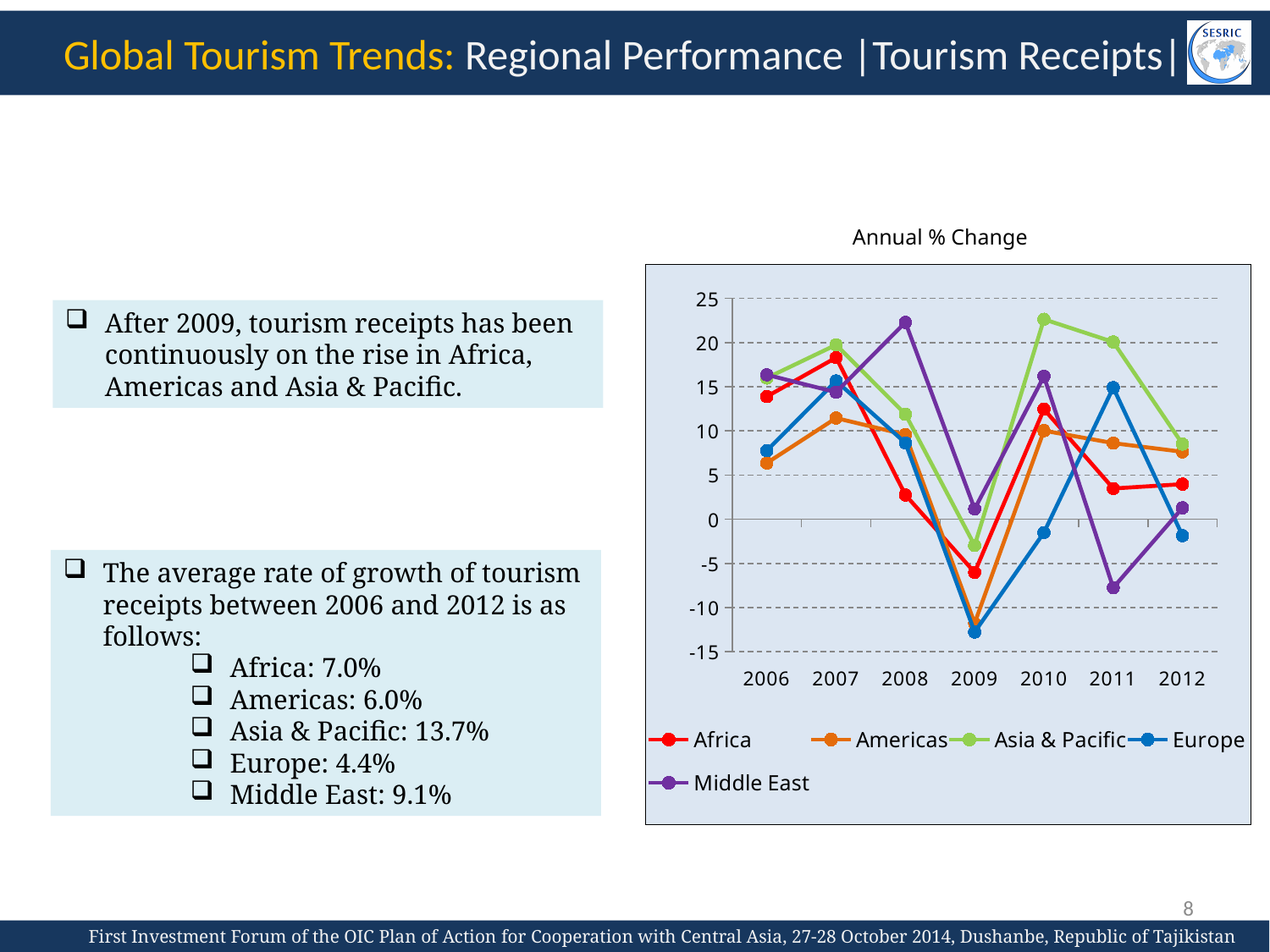
Which region has the highest value in 2010? Asia & Pacific Is the value for Europe in 2009 greater or less than -10? less Which region has the lowest value in 2011? Middle East Does the Asia & Pacific line rise or fall from 2010 to 2012? fall Is the value for Middle East in 2011 greater or less than -5? less How many series does the chart legend list? 5 How many years are shown on the x axis of the chart? 7 In 2006, which is larger: the value for Africa or the value for Americas? Africa Is the value for Asia & Pacific in 2010 greater or less than 20? greater What kind of chart is shown on the slide? line chart What is the title of the chart? Annual % Change